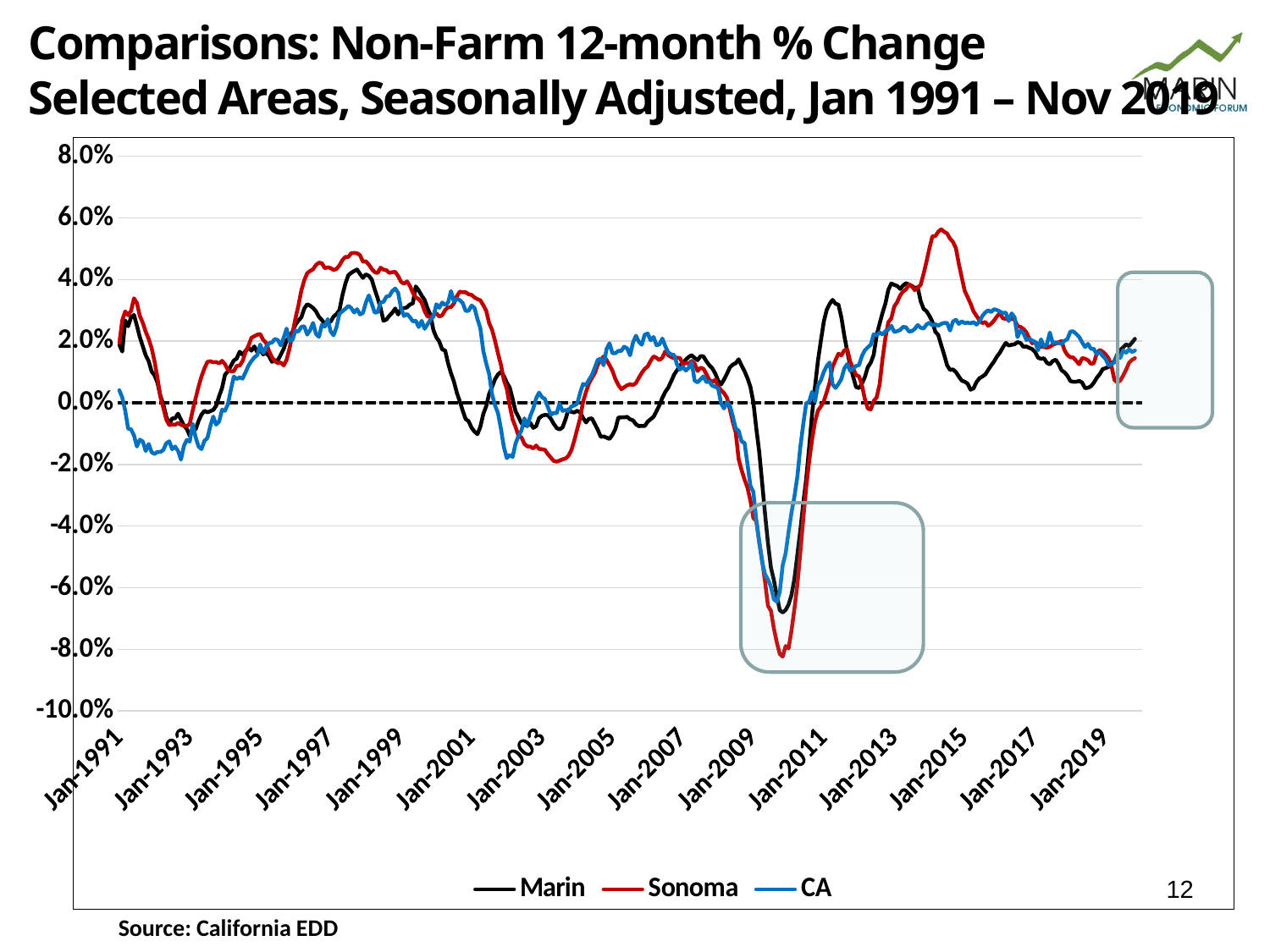
Which series reached the lowest value during the 2009–2010 downturn? Sonoma Is the peak of the Sonoma line around 2014 greater or less than 4.0%? greater Is the value of the CA line around Jan-1993 greater or less than 0.0%? less What is the highest value shown on the y axis? 8.0% What is the source cited below the chart? California EDD Is the lowest value of the Marin line around 2010 greater or less than -6.0%? less What kind of chart is shown on the slide? Line chart Which series are listed in the legend? Marin, Sonoma, CA How many year labels are shown on the x axis? 15 How many series does the legend list? 3 From Jan-2009 to Jan-2010, does the Marin line rise or fall? fall Which series reached the highest peak between Jan-2013 and Jan-2015? Sonoma